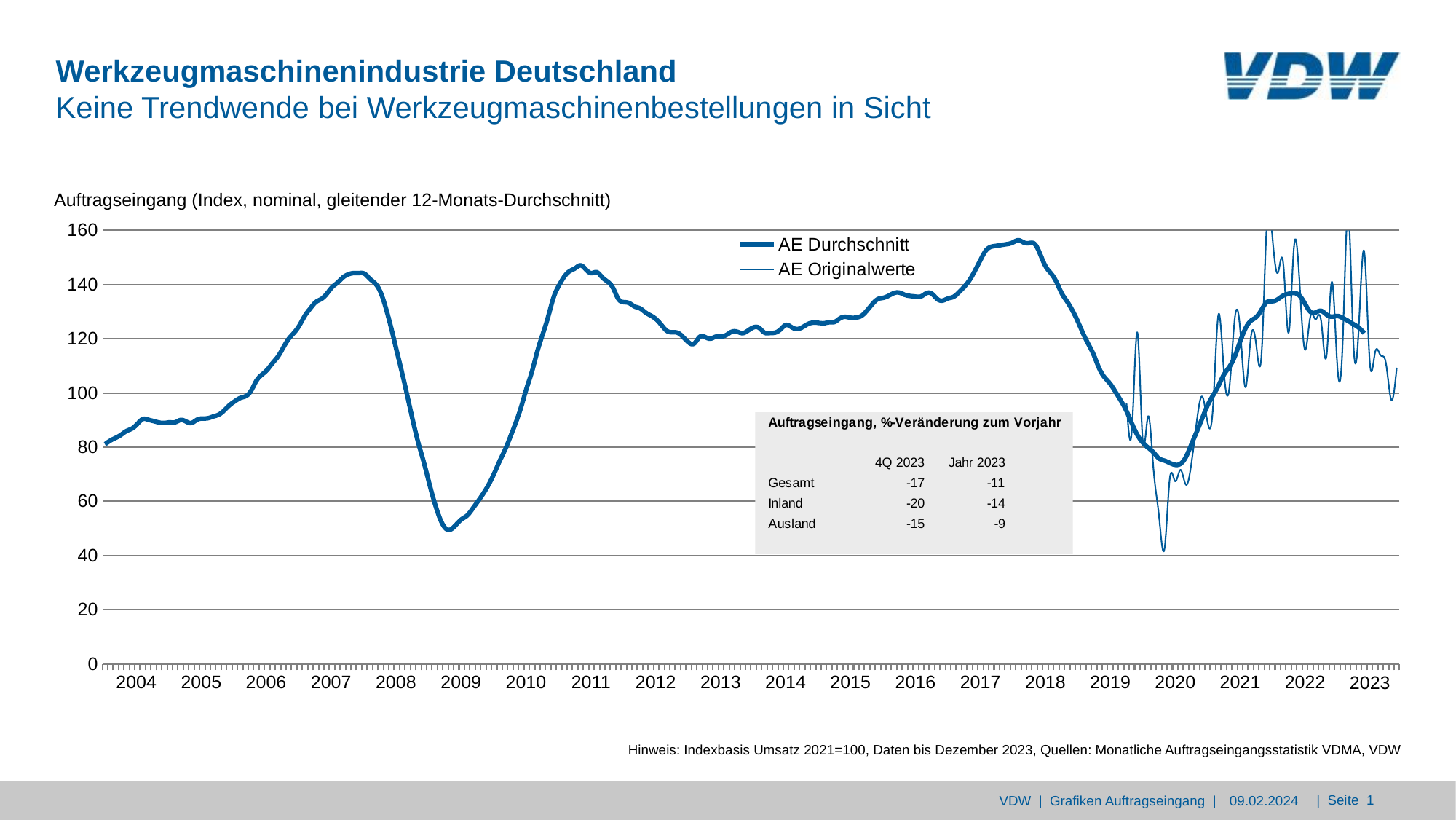
How many years are labelled along the x axis of the chart? 20 Is the value of AE Durchschnitt at its low point in 2020 greater or less than 80? less How many series does the chart legend list? 2 Is the value of AE Durchschnitt at its peak around 2017/2018 greater or less than 140? greater What are the two series named in the chart legend? AE Durchschnitt and AE Originalwerte What is the highest value shown on the vertical axis of the chart? 160 Does the AE Durchschnitt line rise or fall between 2008 and 2009? fall Is the value of AE Durchschnitt at its low point in 2009 greater or less than 60? less What kind of chart is shown on the slide? line chart In the table on the chart, what is the %-change for Gesamt in 4Q 2023? -17 In the table on the chart, what is the %-change for Inland for Jahr 2023? -14 Does the AE Durchschnitt line rise or fall between 2009 and 2011? rise